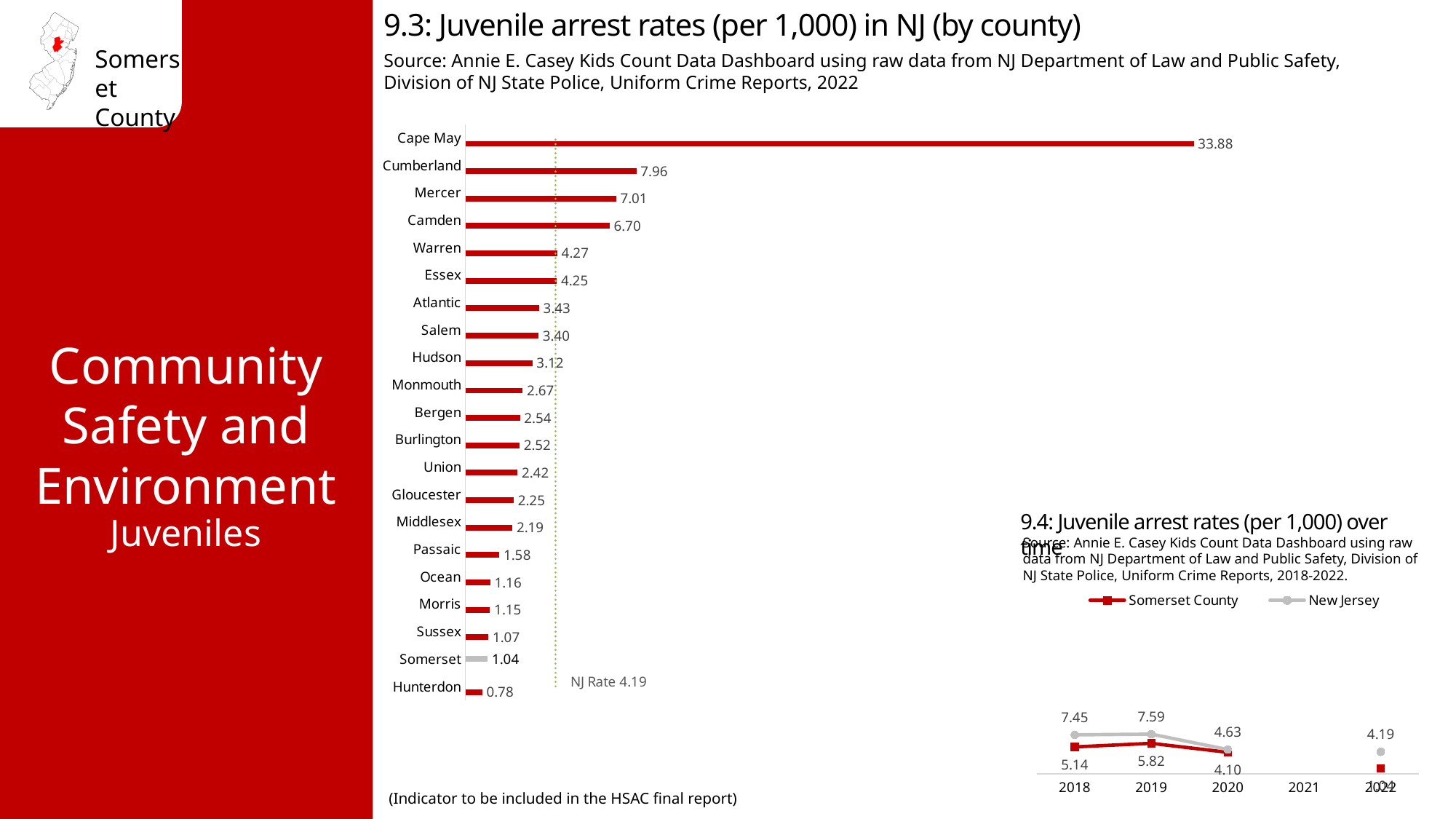
In the chart '9.4: Juvenile arrest rates (per 1,000) over time', what is the value for New Jersey in 2019? 7.59 In the chart '9.3: Juvenile arrest rates (per 1,000) in NJ (by county)', which has a higher value, Camden or Warren? Camden In the chart '9.3: Juvenile arrest rates (per 1,000) in NJ (by county)', what is the difference between the values for Cumberland and Mercer? 0.95 In the chart '9.4: Juvenile arrest rates (per 1,000) over time', what is the value for Somerset County in 2020? 4.10 In the chart '9.3: Juvenile arrest rates (per 1,000) in NJ (by county)', which county has the highest juvenile arrest rate? Cape May In the chart '9.3: Juvenile arrest rates (per 1,000) in NJ (by county)', what is the value for Somerset? 1.04 In the chart '9.3: Juvenile arrest rates (per 1,000) in NJ (by county)', what NJ rate is marked by the dotted reference line? 4.19 In the chart '9.3: Juvenile arrest rates (per 1,000) in NJ (by county)', how many counties are shown? 21 How many series does the legend of the chart '9.4: Juvenile arrest rates (per 1,000) over time' list? 2 In the chart '9.3: Juvenile arrest rates (per 1,000) in NJ (by county)', what is the value for Cape May? 33.88 What kind of chart is '9.3: Juvenile arrest rates (per 1,000) in NJ (by county)'? Bar chart In the chart '9.3: Juvenile arrest rates (per 1,000) in NJ (by county)', which county has the lowest juvenile arrest rate? Hunterdon